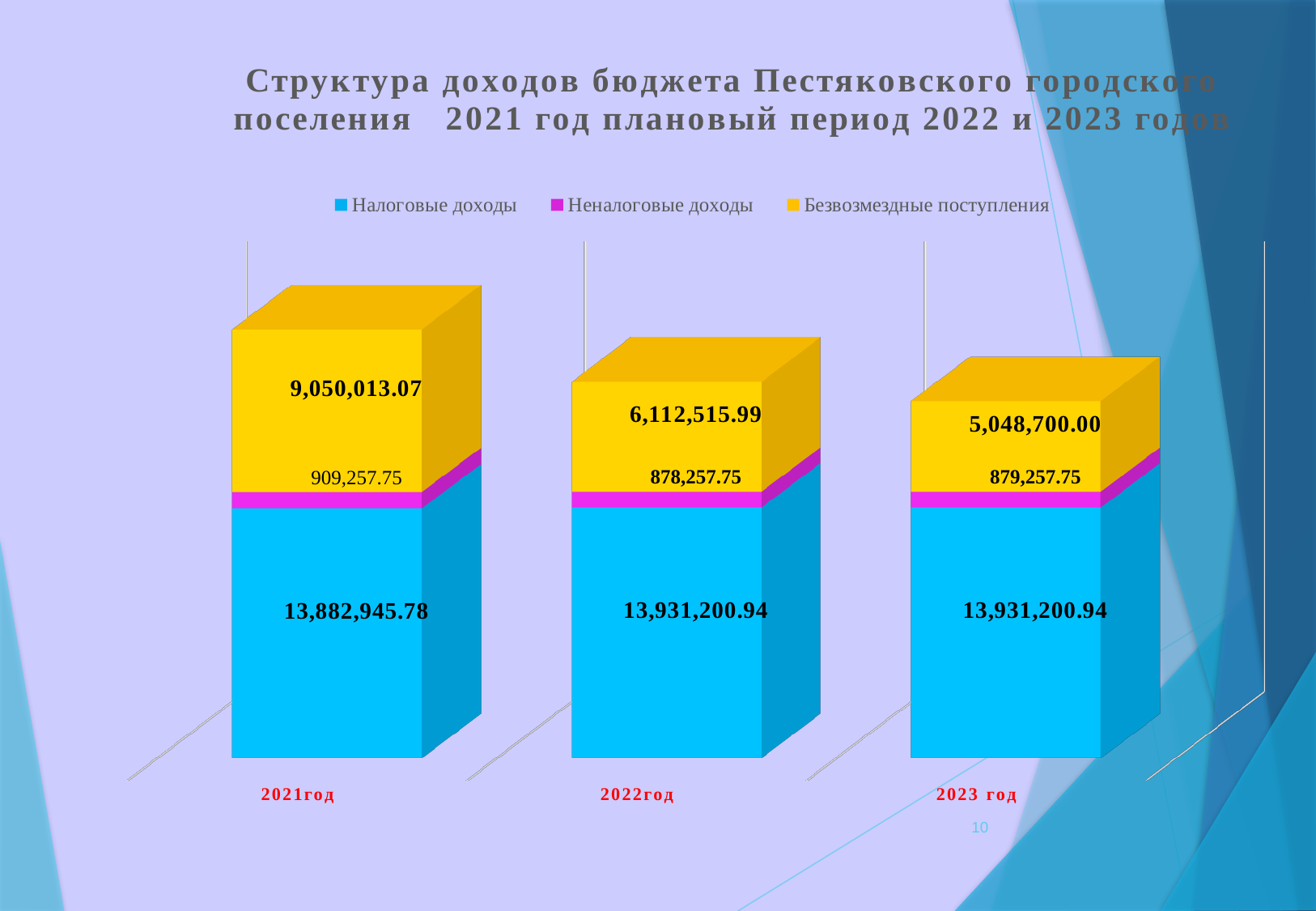
Which is larger: Неналоговые доходы in 2021год or in 2022год? 2021год What is the difference between Безвозмездные поступления in 2021год and 2022год? 2,937,497.08 Do the values of Безвозмездные поступления rise or fall from 2021год to 2023 год? Fall How many series does the legend list? 3 What is the value of Безвозмездные поступления for 2022год? 6,112,515.99 What kind of chart is shown on the slide? Stacked bar chart In which year is Безвозмездные поступления the lowest? 2023 год What is the total of the stacked bar for 2023 год? 19,859,158.69 What is the value of Налоговые доходы for 2021год? 13,882,945.78 What is the value of Неналоговые доходы for 2023 год? 879,257.75 In which year is Безвозмездные поступления the highest? 2021год How many years are shown on the x axis? 3